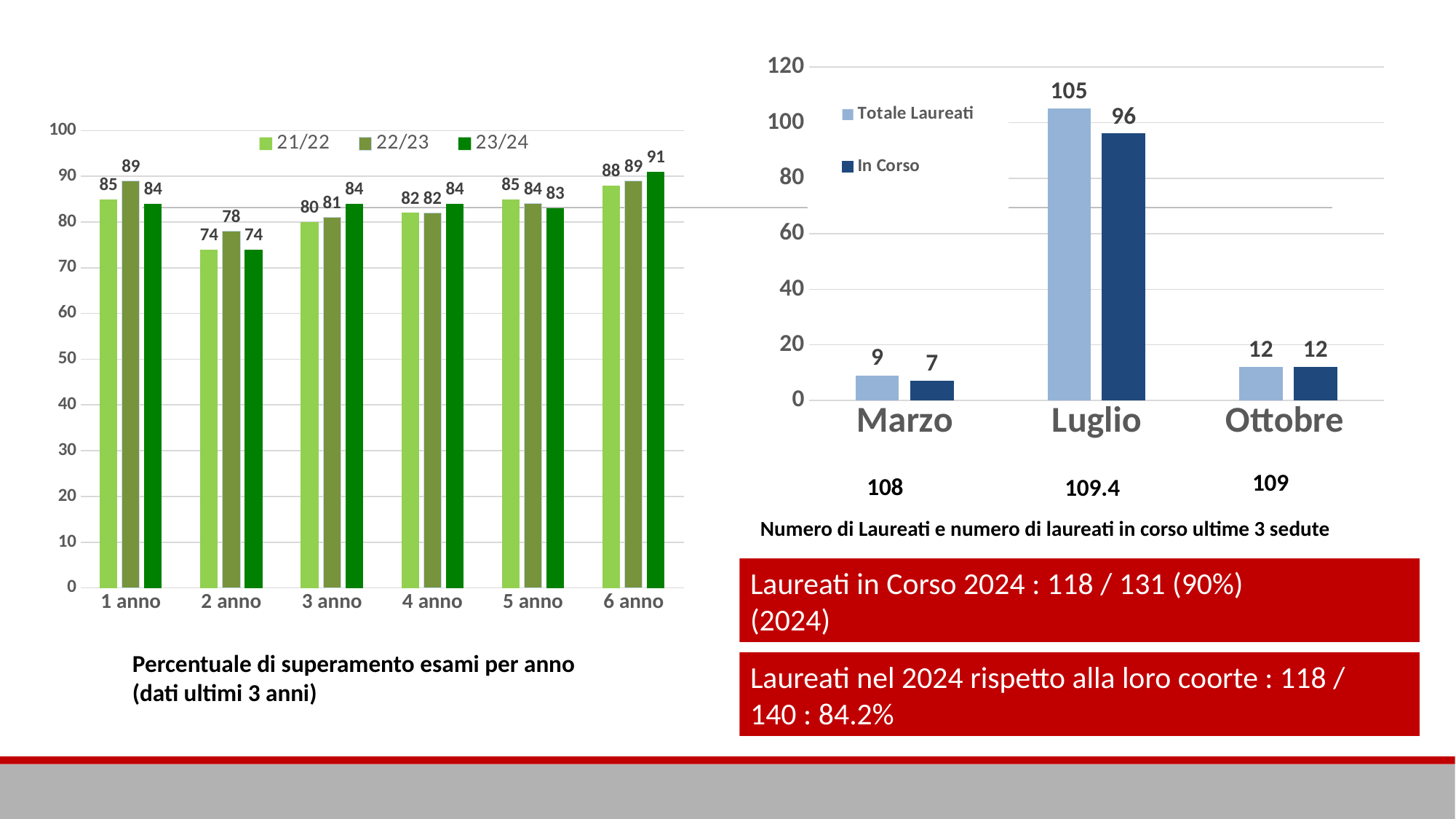
In the right chart (Numero di Laureati e numero di laureati in corso ultime 3 sedute), what is the In Corso value for Marzo? 7 In the right chart (Numero di Laureati e numero di laureati in corso ultime 3 sedute), which session has the highest Totale Laureati value? Luglio In the right chart (Numero di Laureati e numero di laureati in corso ultime 3 sedute), what is the Totale Laureati value for Luglio? 105 In the left chart (Percentuale di superamento esami per anno), what is the difference between the 22/23 and 21/22 values in 1 anno? 4 In the left chart (Percentuale di superamento esami per anno), what is the value for 22/23 in 2 anno? 78 In the left chart (Percentuale di superamento esami per anno), which year category has the lowest value for the 21/22 series? 2 anno In the left chart (Percentuale di superamento esami per anno), how many series does the legend list? 3 In the left chart (Percentuale di superamento esami per anno), what is the value for 23/24 in 6 anno? 91 In the right chart (Numero di Laureati e numero di laureati in corso ultime 3 sedute), what is the difference between Totale Laureati and In Corso for Luglio? 9 In the right chart (Numero di Laureati e numero di laureati in corso ultime 3 sedute), is the Totale Laureati value for Ottobre greater or less than 20? less In the left chart (Percentuale di superamento esami per anno), how many year categories are shown on the x axis? 6 What kind of chart is the right chart (Numero di Laureati e numero di laureati in corso ultime 3 sedute)? bar chart